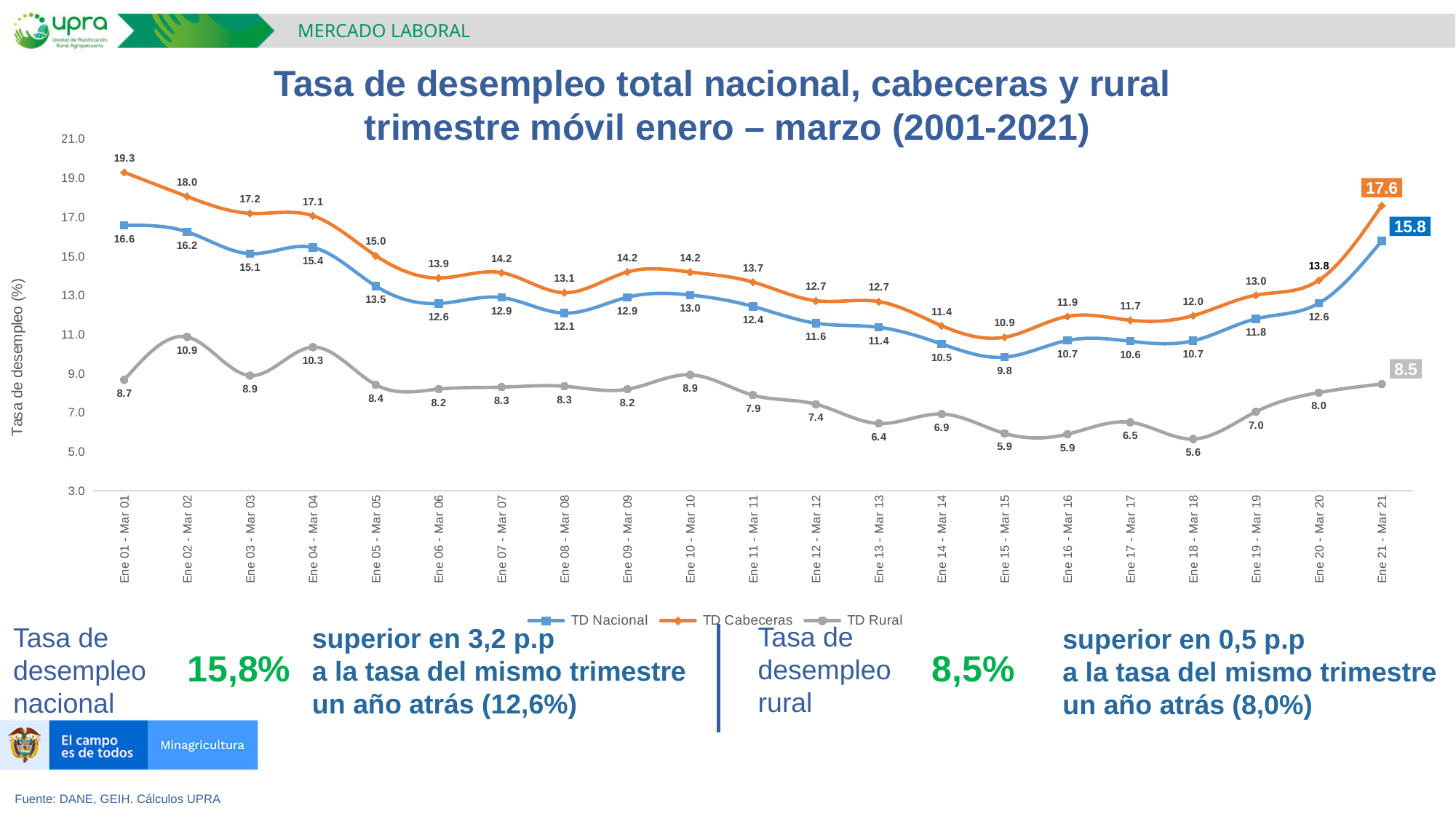
In which period does TD Rural reach its highest value? Ene 02 - Mar 02 How many periods are plotted on the x axis? 21 What is the value of TD Rural for Ene 18 - Mar 18? 5.6 How many series does the legend list? 3 Which series is drawn in orange? TD Cabeceras Which is larger, TD Rural for Ene 04 - Mar 04 or TD Rural for Ene 05 - Mar 05? Ene 04 - Mar 04 What is the difference between TD Cabeceras and TD Nacional for Ene 21 - Mar 21? 1.8 What type of chart is shown on the slide? Line chart What is the difference between TD Nacional for Ene 21 - Mar 21 and Ene 20 - Mar 20? 3.2 What is the value of TD Cabeceras for Ene 01 - Mar 01? 19.3 In which period does TD Nacional reach its lowest value? Ene 15 - Mar 15 What is the value of TD Nacional for Ene 21 - Mar 21? 15.8